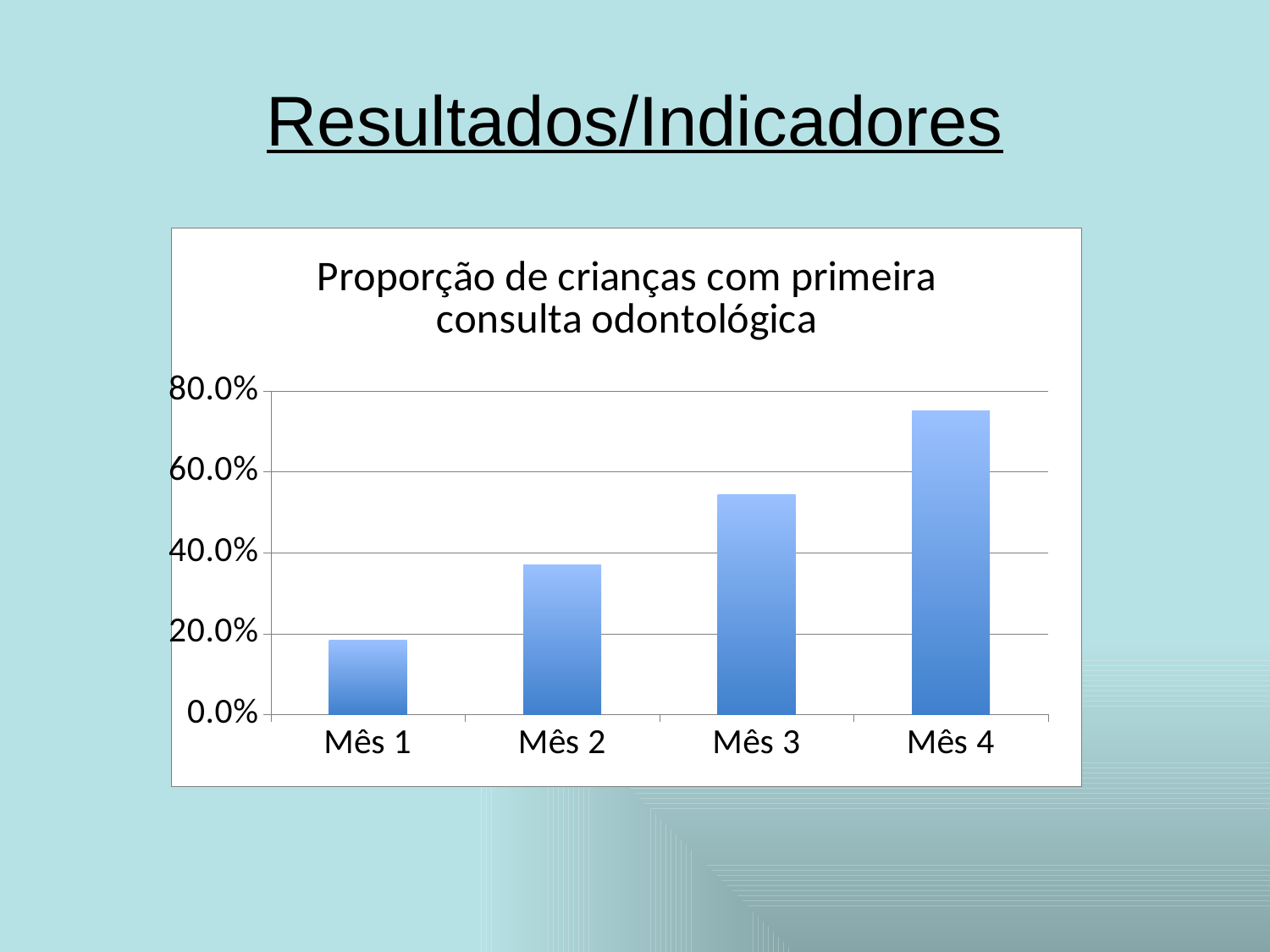
Is the value for Mês 1 greater or less than 20.0%? less Is the value for Mês 3 greater or less than 40.0%? greater Is the value for Mês 2 greater or less than 40.0%? less Which is larger, the value for Mês 2 or the value for Mês 3? Mês 3 Which month has the highest value? Mês 4 Which month has the lowest value? Mês 1 Do the values rise or fall from Mês 1 to Mês 4? rise What kind of chart is shown on the slide? bar chart What is the title of the chart? Proporção de crianças com primeira consulta odontológica How many categories are shown on the x axis? 4 What is the highest value shown on the y axis? 80.0%